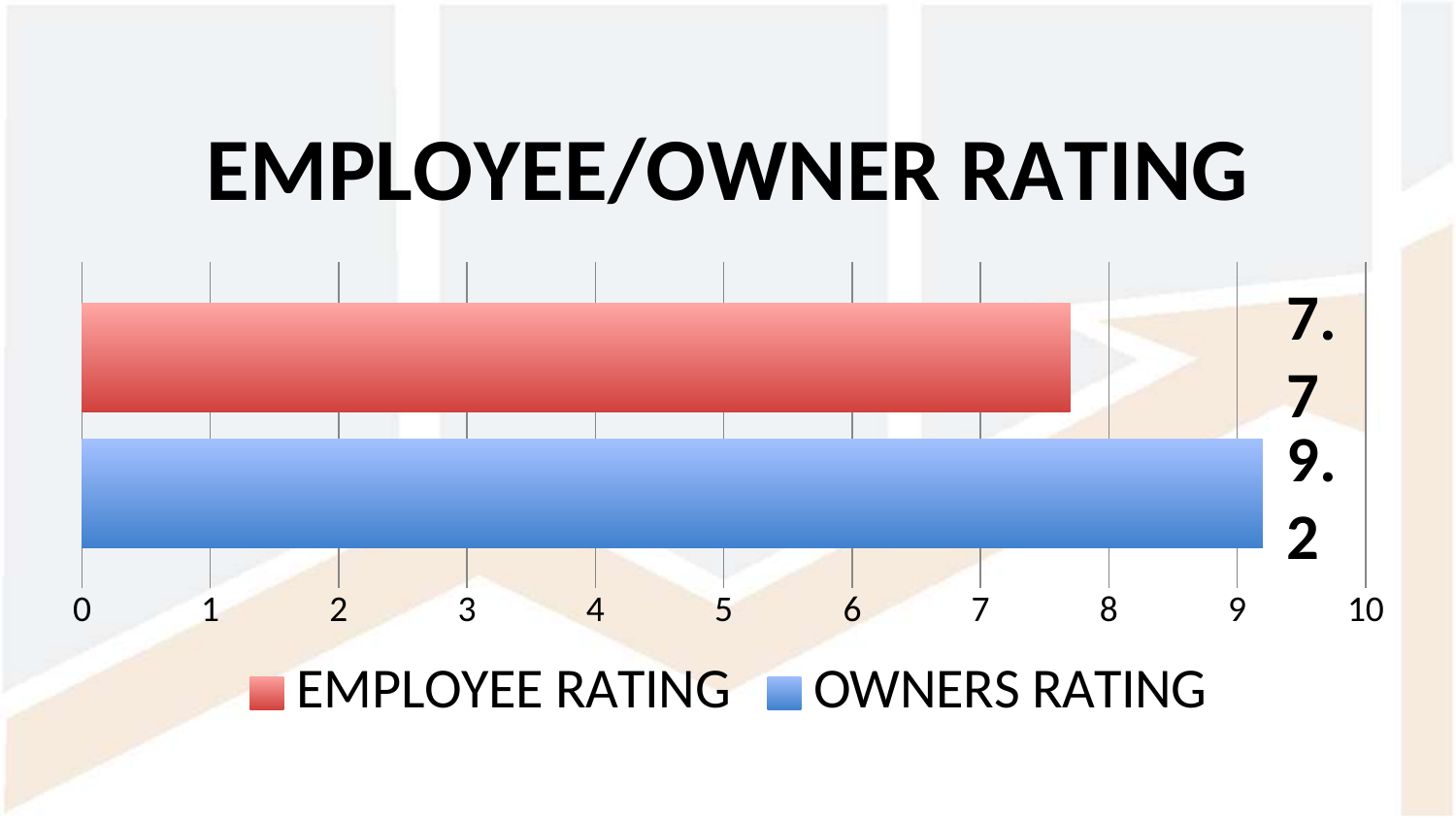
Which series has the lowest value? EMPLOYEE RATING How many series does the legend list? 2 What kind of chart is shown on the slide? bar chart What is the value for EMPLOYEE RATING? 7.7 What is the difference between the OWNERS RATING and the EMPLOYEE RATING? 1.5 Which series has the highest value? OWNERS RATING What is the value for OWNERS RATING? 9.2 Is the value for EMPLOYEE RATING greater or less than 8? less Is the value for OWNERS RATING greater or less than 9? greater What colour is the bar for OWNERS RATING? blue What is the title of the chart? EMPLOYEE/OWNER RATING Which series has the higher value, EMPLOYEE RATING or OWNERS RATING? OWNERS RATING